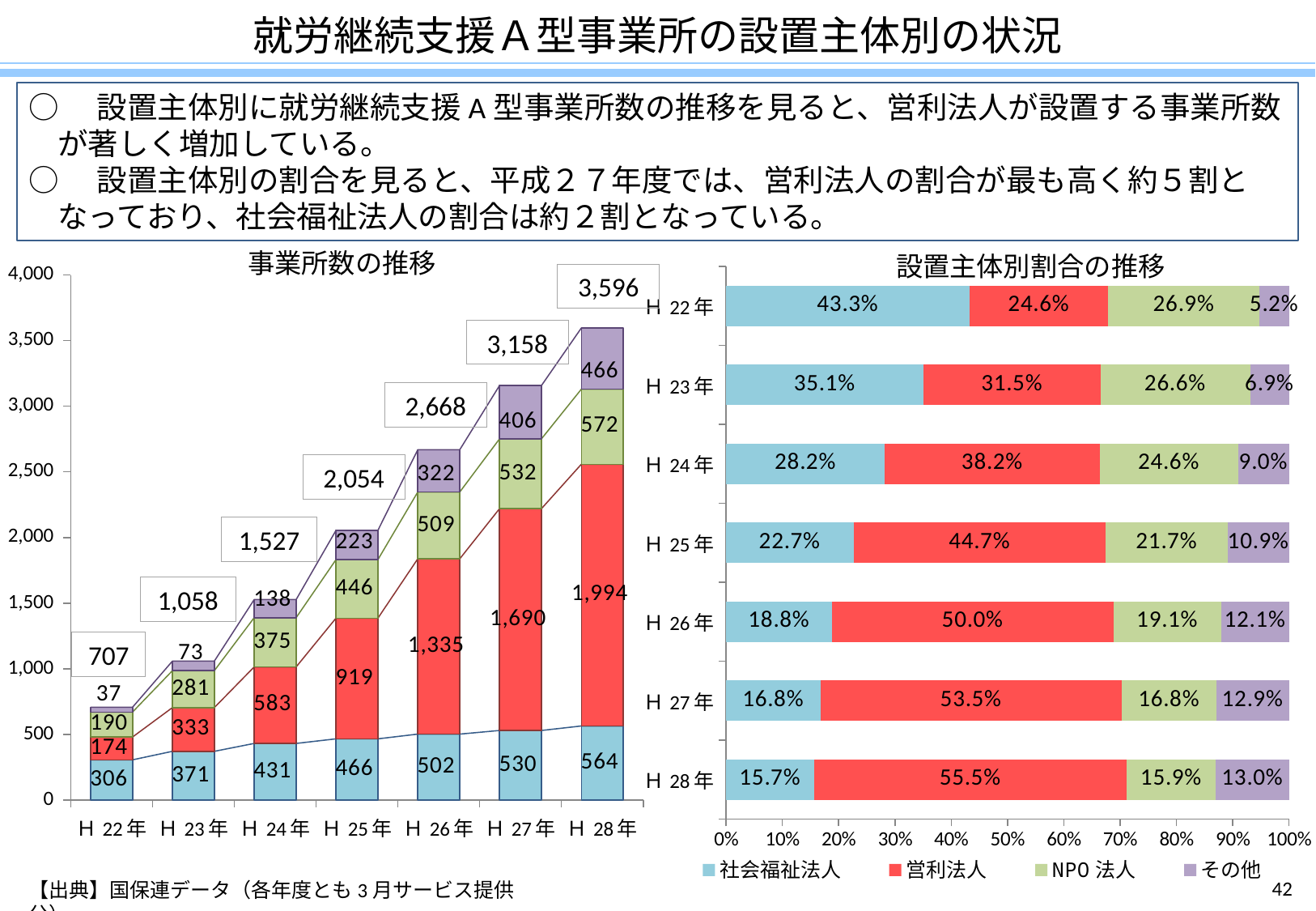
In the chart titled 設置主体別割合の推移, what is the share of その他 for H 24年? 9.0% In the chart titled 事業所数の推移, how many years are shown on the x axis? 7 In the chart titled 事業所数の推移, what is the total number of establishments shown for H 28年? 3,596 In the chart titled 事業所数の推移, what is the value of the blue 社会福祉法人 segment for H 22年? 306 In the chart titled 事業所数の推移, what is the value of the red 営利法人 segment for H 26年? 1,335 In the chart titled 設置主体別割合の推移, which year has the highest share for 社会福祉法人? H 22年 In the chart titled 事業所数の推移, what is the difference between the totals for H 28年 and H 27年? 438 In the chart titled 事業所数の推移, do the totals rise or fall from H 22年 to H 28年? rise In the chart titled 設置主体別割合の推移, what is the share of 営利法人 for H 27年? 53.5% In the chart titled 設置主体別割合の推移, is the share of 営利法人 larger for H 25年 or for H 23年? H 25年 How many series does the legend at the bottom right of the slide list? 4 In the chart titled 事業所数の推移, which year has the lowest total? H 22年